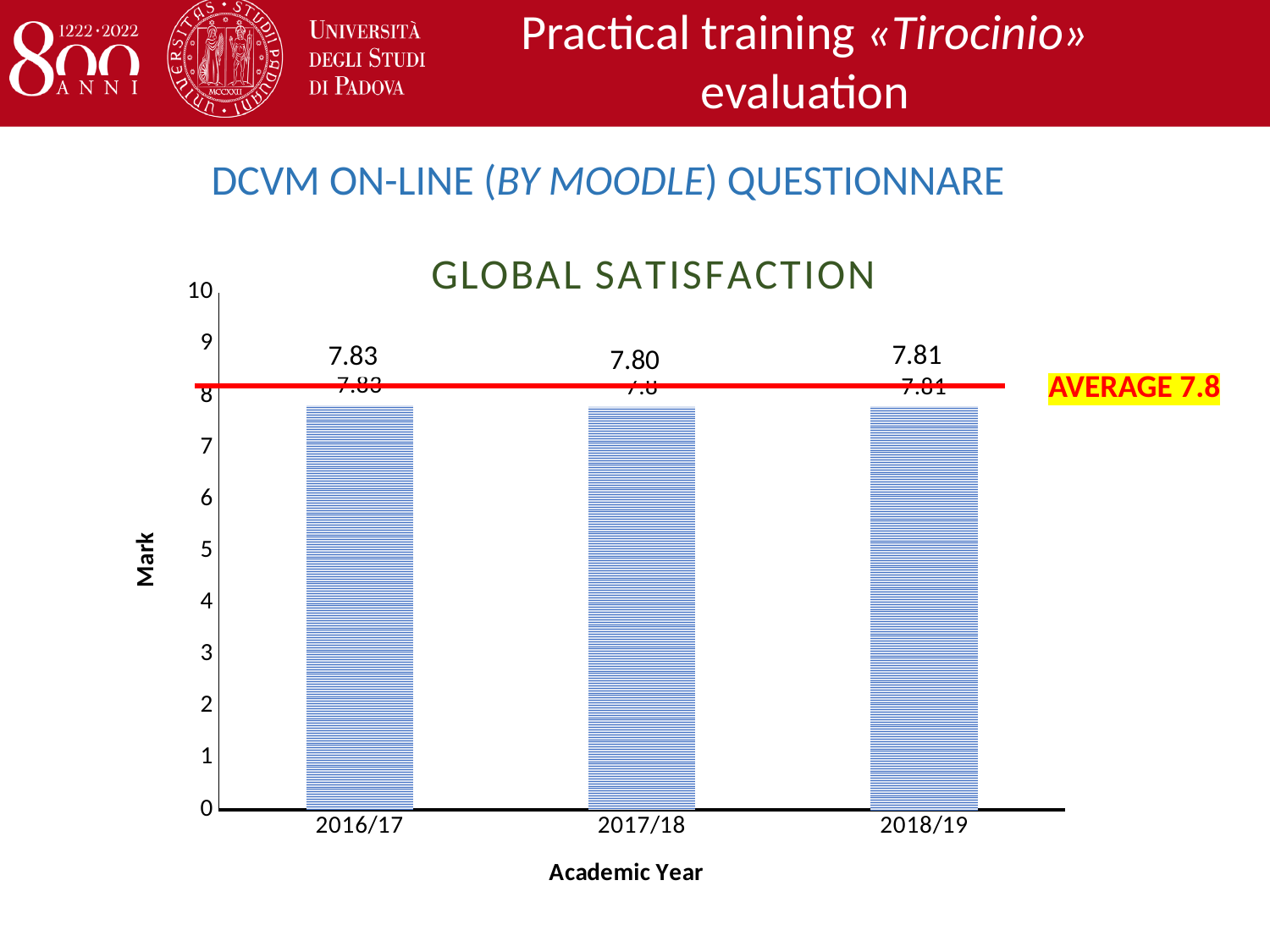
How many academic years are shown in the chart? 3 Which academic year has the highest global satisfaction mark? 2016/17 Which academic year has the lowest global satisfaction mark? 2017/18 What is the global satisfaction mark for 2016/17? 7.83 What is the global satisfaction mark for 2017/18? 7.80 Which has a higher mark, 2018/19 or 2017/18? 2018/19 What is the difference between the marks for 2016/17 and 2017/18? 0.03 What is the global satisfaction mark for 2018/19? 7.81 What kind of chart is shown on the slide? bar chart What is the title of the chart? GLOBAL SATISFACTION What average value is indicated by the red line on the chart? 7.8 Is the value for 2017/18 greater or less than 8? less